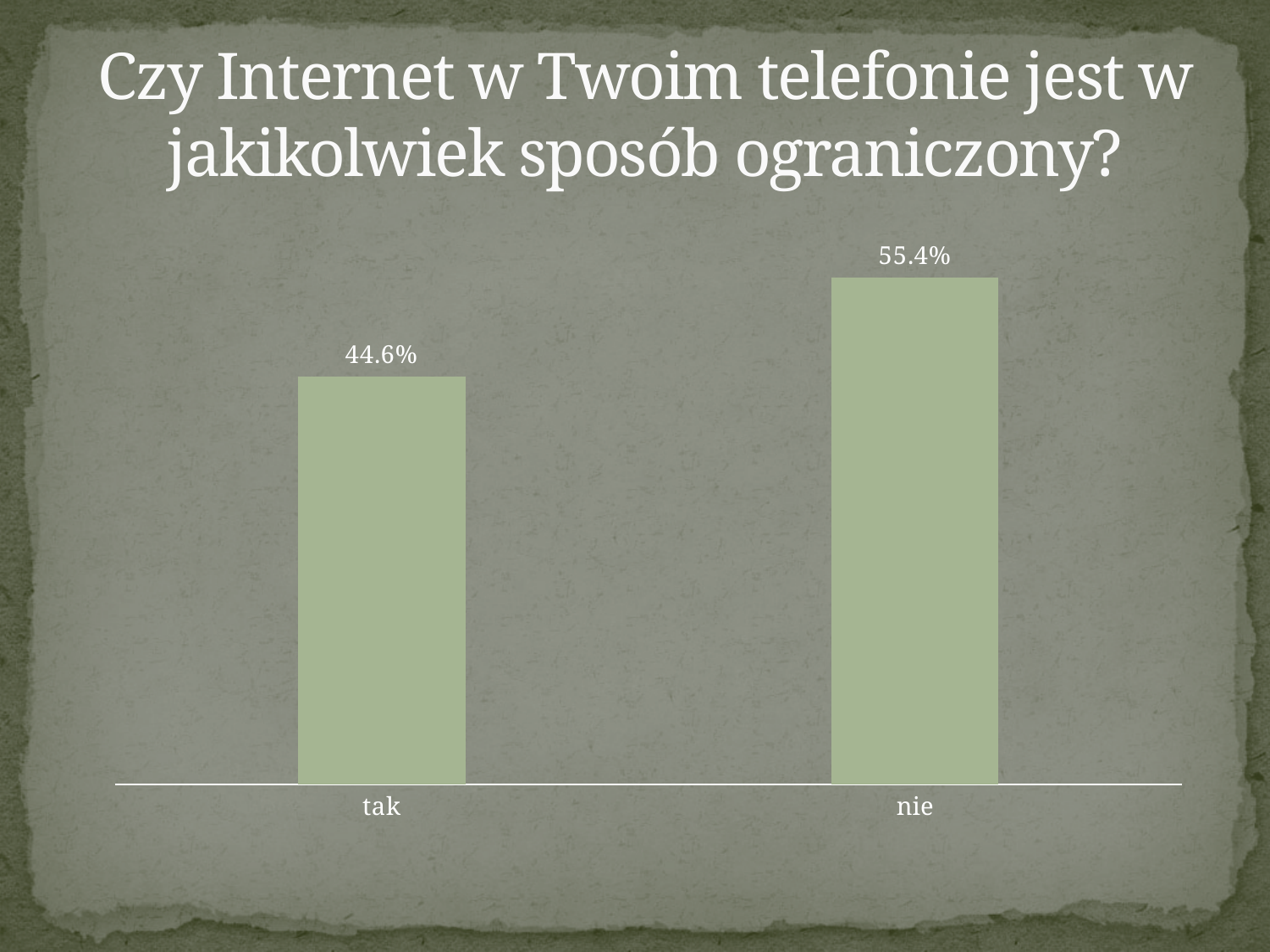
What is the value for "tak"? 44.6% Which is larger, the value for "tak" or the value for "nie"? nie How many categories are shown on the chart? 2 What is the value for "nie"? 55.4% Which category has the lowest value? tak Which category has the highest value? nie What is the title of the slide? Czy Internet w Twoim telefonie jest w jakikolwiek sposób ograniczony? What is the total of the two values shown on the chart? 100% What colour are the bars on the chart? green What kind of chart is shown on the slide? bar chart What is the difference between the values for "nie" and "tak"? 10.8%